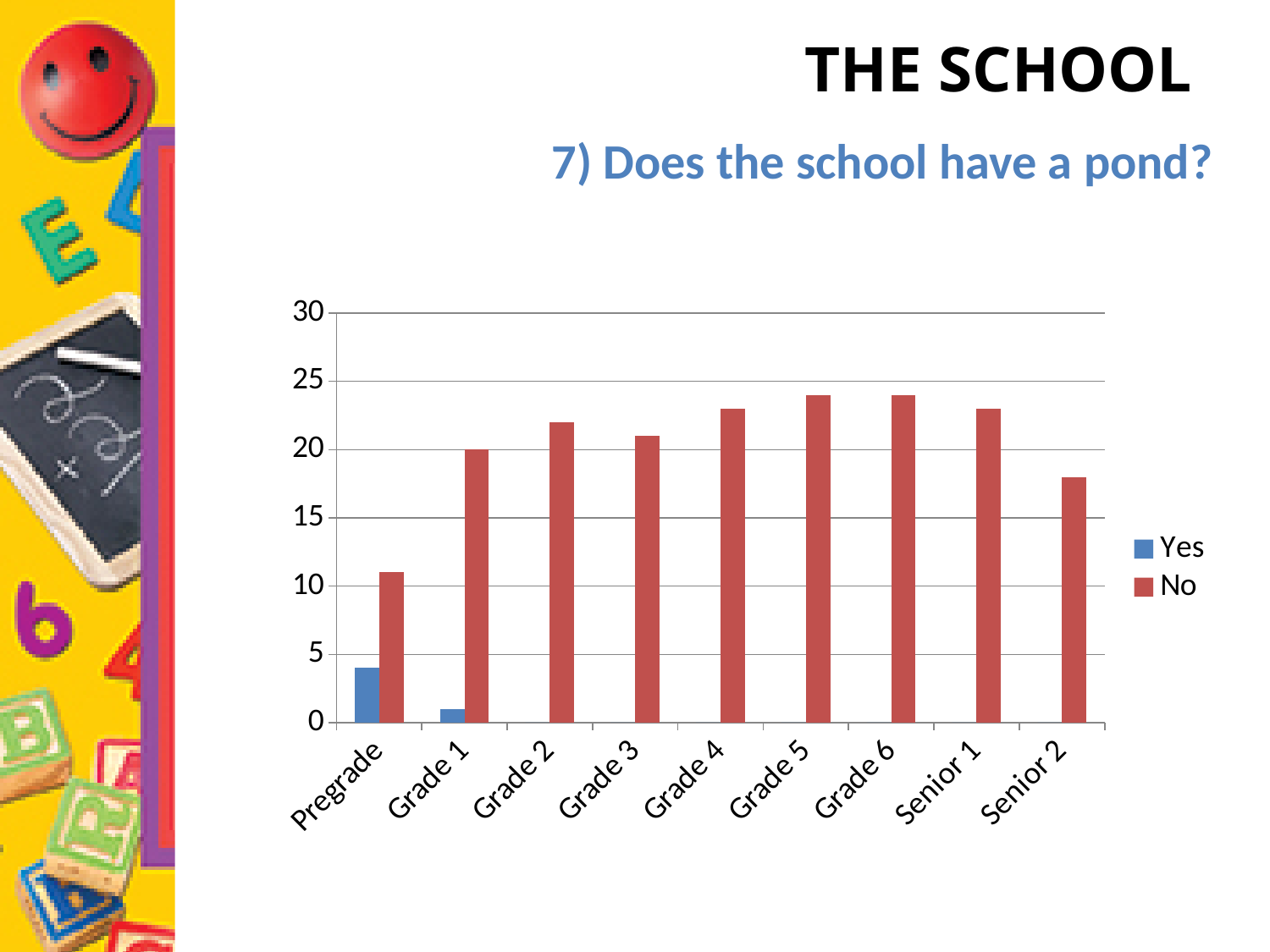
What kind of chart is shown on the slide? Bar chart Is the 'No' value for Pregrade greater or less than 15? less Is the 'No' value for Senior 2 greater or less than 15? greater For Pregrade, which is larger, the 'Yes' value or the 'No' value? No What question does the chart's heading ask? 7) Does the school have a pond? Is the 'No' value for Grade 5 greater or less than 25? less How many categories are shown on the x axis? 9 Which has the larger 'Yes' value, Pregrade or Grade 1? Pregrade How many series does the legend list? 2 What are the two entries in the legend? Yes and No Which category has the lowest 'No' value? Pregrade